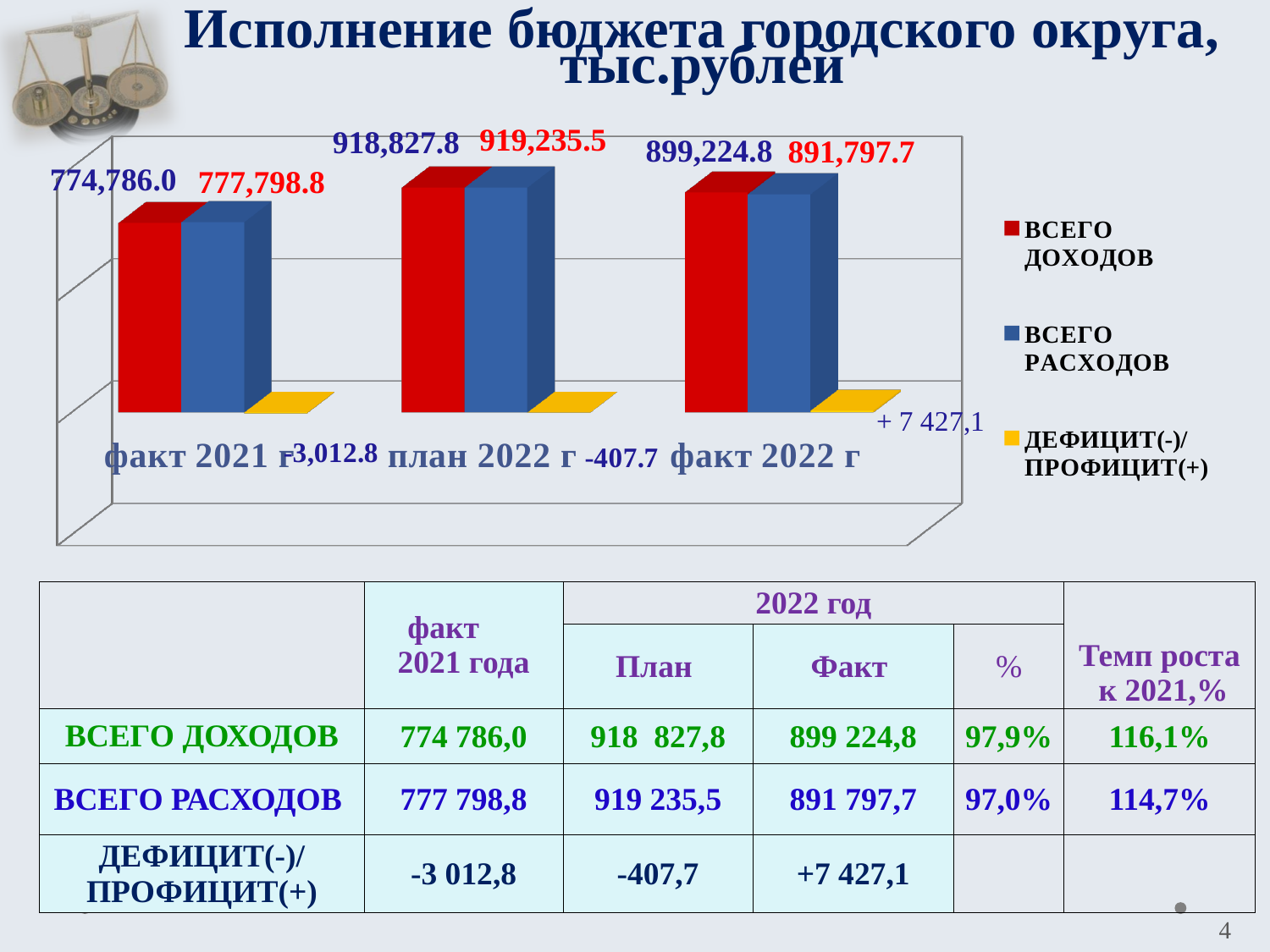
How many categories are shown on the x axis of the chart? 3 What is the value of ДЕФИЦИТ(-)/ПРОФИЦИТ(+) for факт 2021 г? -3,012.8 Which category has the lowest value for ВСЕГО РАСХОДОВ? факт 2021 г Which category has the highest value for ВСЕГО ДОХОДОВ? план 2022 г What is the value of ВСЕГО РАСХОДОВ for план 2022 г? 919,235.5 What is the difference between ВСЕГО ДОХОДОВ for план 2022 г and for факт 2021 г? 144,041.8 What is the value of ВСЕГО ДОХОДОВ for факт 2021 г? 774,786.0 How many series does the chart legend list? 3 For факт 2022 г, which is larger: ВСЕГО ДОХОДОВ or ВСЕГО РАСХОДОВ? ВСЕГО ДОХОДОВ What is the difference between ВСЕГО ДОХОДОВ and ВСЕГО РАСХОДОВ for факт 2022 г? 7,427.1 What kind of chart is shown on the slide? bar chart What is the value of ДЕФИЦИТ(-)/ПРОФИЦИТ(+) for факт 2022 г? + 7 427,1